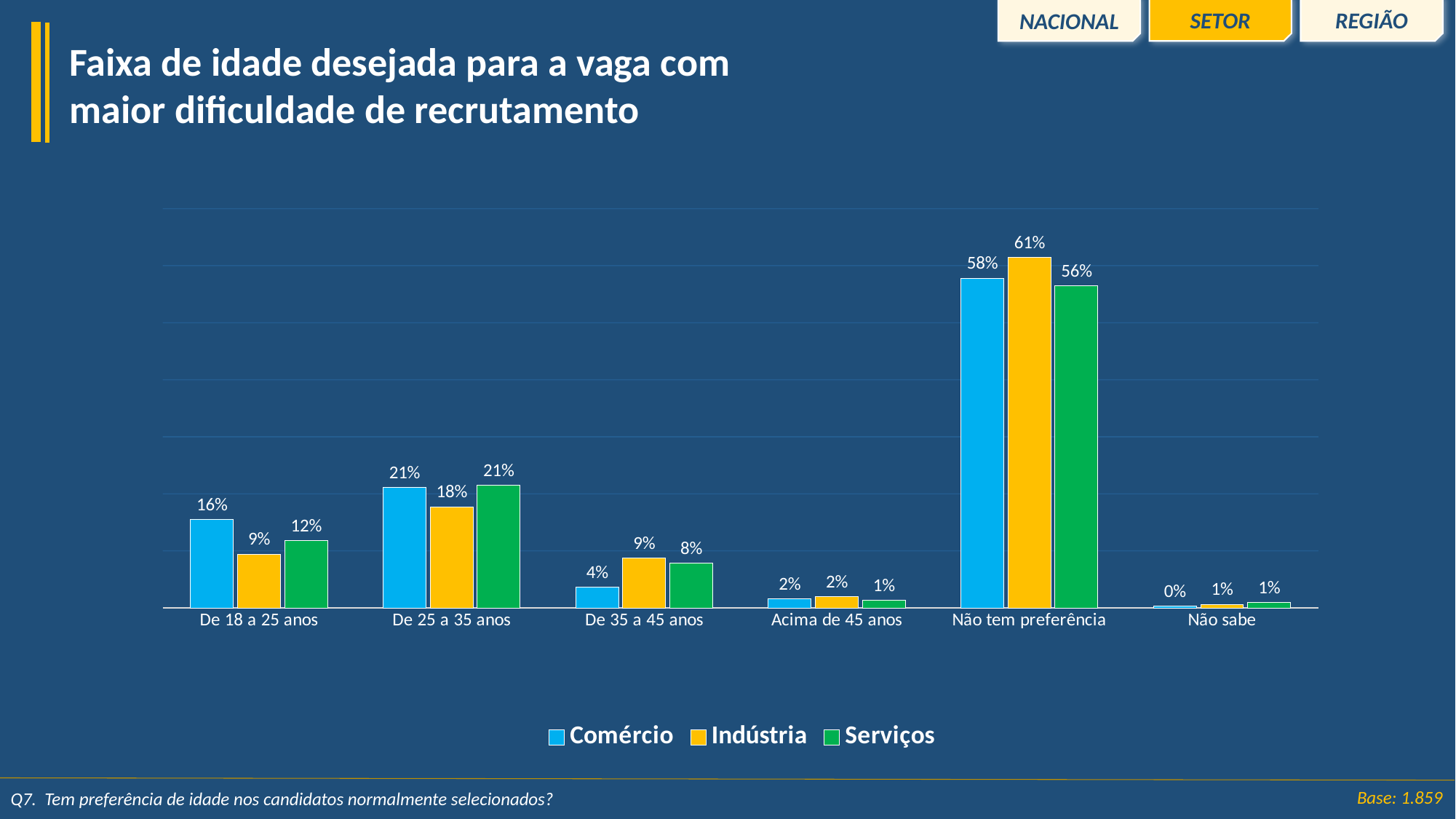
How many series does the legend list? 3 What is the difference between the Indústria and Comércio values in the 'Não tem preferência' category? 3% What is the value for Indústria in the 'Não tem preferência' category? 61% What is the value for Comércio in the 'De 18 a 25 anos' category? 16% What kind of chart is shown on the slide? Bar chart Which category has the lowest value for Comércio? Não sabe What is the value for Serviços in the 'De 35 a 45 anos' category? 8% In the 'De 18 a 25 anos' category, which series has the larger value, Comércio or Serviços? Comércio Which series is shown in green in the legend? Serviços What is the difference between the Comércio and Indústria values in the 'De 18 a 25 anos' category? 7% Which category has the highest value for Serviços? Não tem preferência How many age categories are shown on the x axis? 6